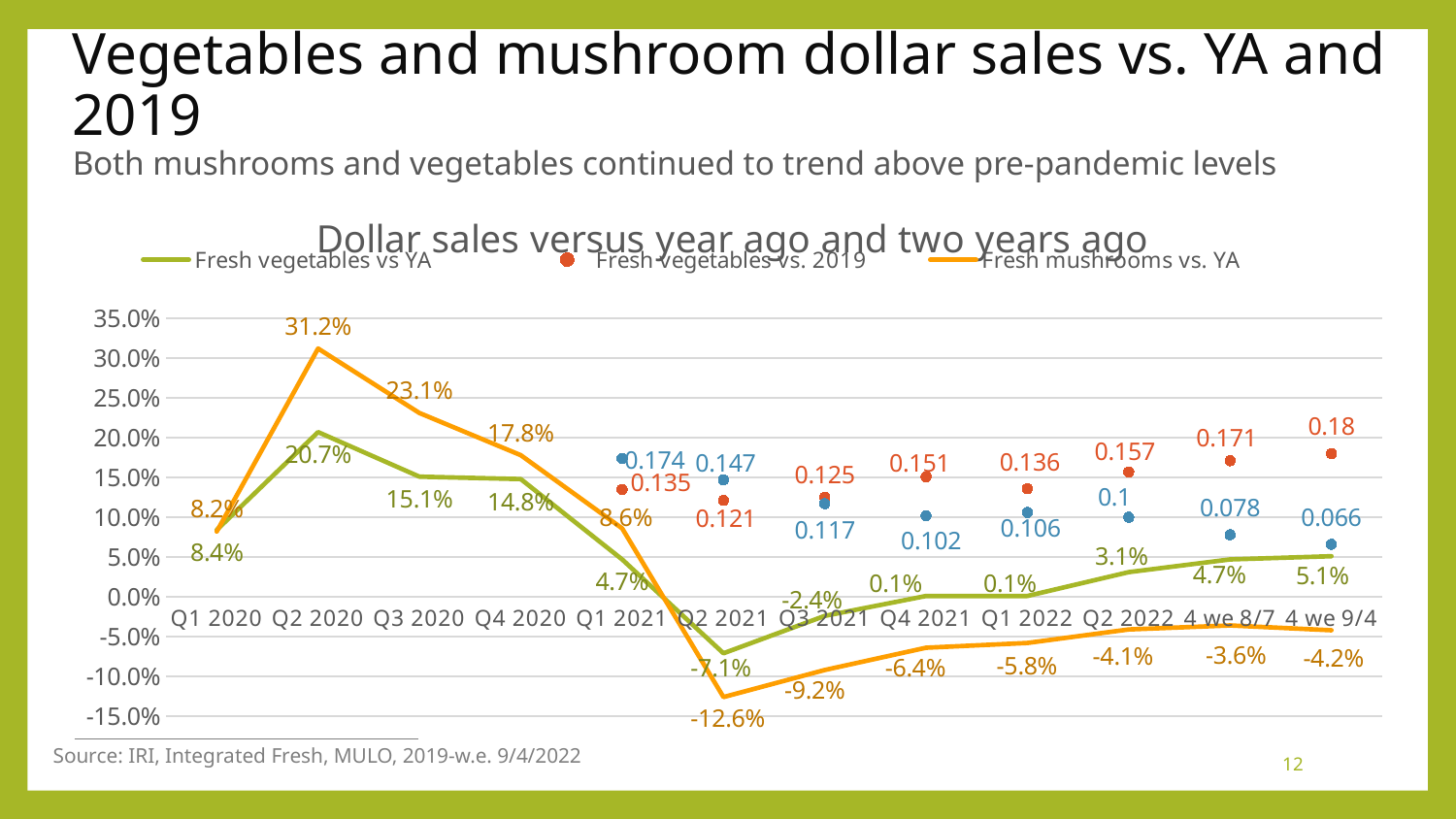
In which period does Fresh mushrooms vs. YA reach its highest value? Q2 2020 How many series does the legend list? 3 Does Fresh mushrooms vs. YA rise or fall from Q2 2020 to Q2 2021? Fall What is the value for Fresh vegetables vs YA in Q1 2021? 4.7% What is the title of the chart? Dollar sales versus year ago and two years ago In which period does Fresh vegetables vs YA reach its lowest value? Q2 2021 What is the value for Fresh vegetables vs. 2019 at 4 we 9/4? 0.18 What is the difference between Fresh mushrooms vs. YA and Fresh vegetables vs YA in Q2 2020? 10.5 percentage points What is the value for Fresh mushrooms vs. YA in Q2 2020? 31.2% How many time periods are shown on the x axis? 12 What kind of chart is shown on the slide? Line chart In Q3 2020, which is larger: Fresh mushrooms vs. YA or Fresh vegetables vs YA? Fresh mushrooms vs. YA